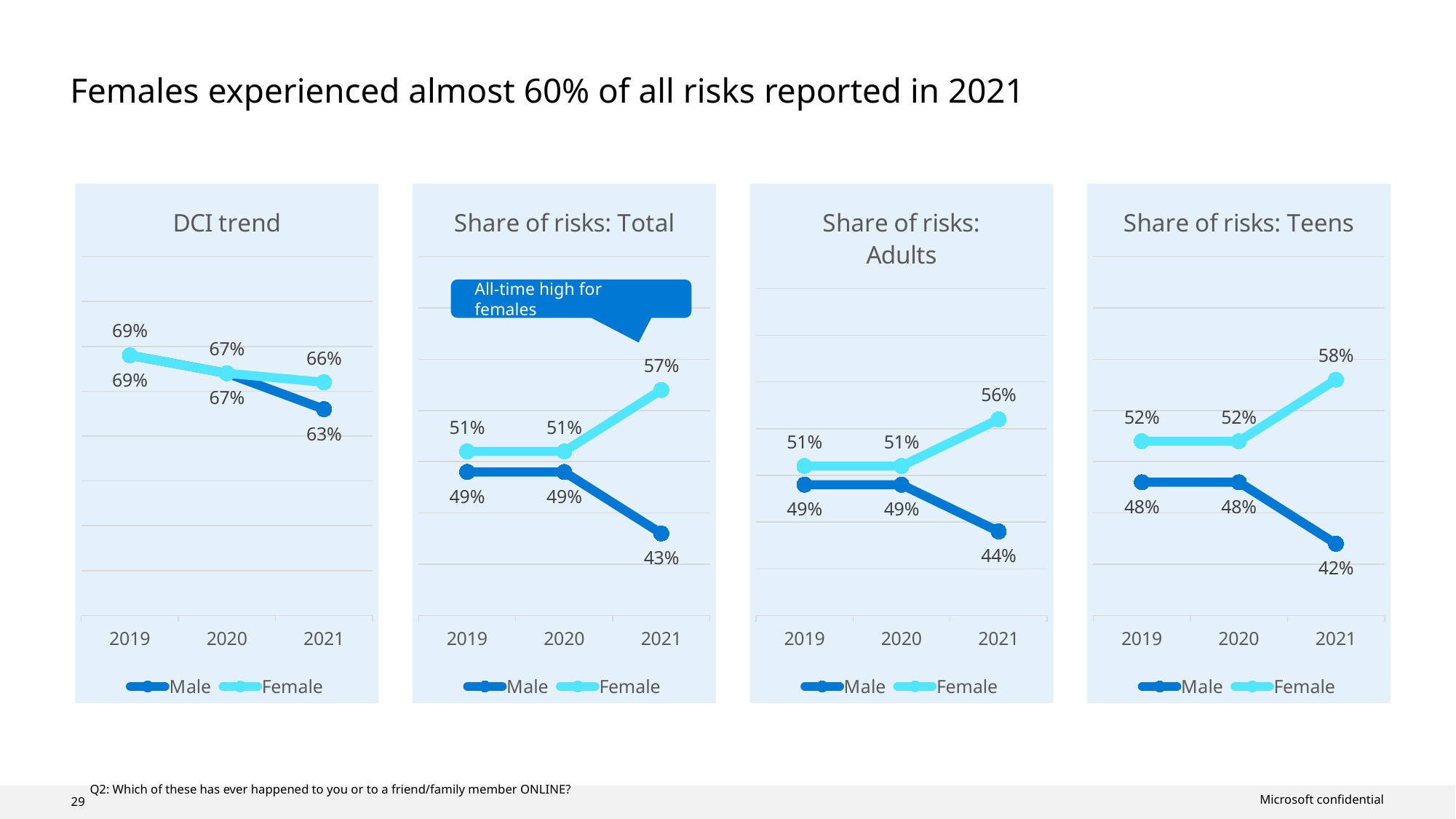
In the 'Share of risks: Teens' chart, does the Male line rise or fall from 2020 to 2021? fall What kind of chart is 'Share of risks: Total'? line chart In the 'Share of risks: Teens' chart, which year has the highest Female value? 2021 In the 'Share of risks: Total' chart, what is the difference between the Female and Male values in 2021? 14% How many series does the legend of the 'DCI trend' chart list? 2 How many years are shown on the x axis of the 'Share of risks: Adults' chart? 3 In the 'Share of risks: Total' chart, what is the Female value in 2021? 57% In the 'Share of risks: Teens' chart, what is the Male value in 2019? 48% In the 'DCI trend' chart, what is the value for Female in 2021? 66% In the 'Share of risks: Adults' chart, which is larger in 2021, the Male or the Female value? Female In the 'DCI trend' chart, what is the value for Male in 2021? 63% In the 'Share of risks: Adults' chart, what is the Male value in 2021? 44%